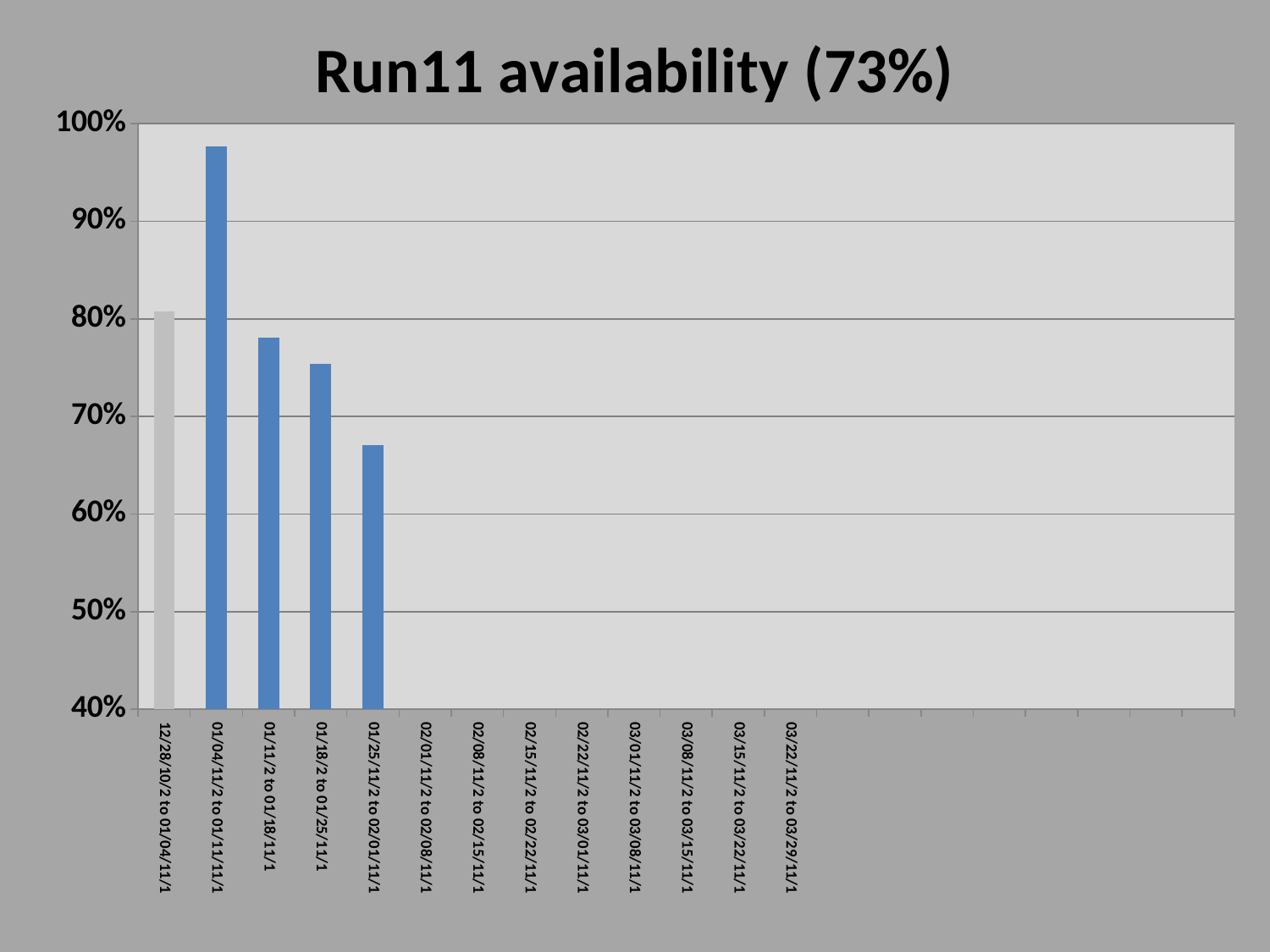
How many category labels are shown along the x axis? 13 Which is larger, the value for 01/11/2 to 01/18/11/1 or the value for 01/18/2 to 01/25/11/1? 01/11/2 to 01/18/11/1 Which period has the highest availability? 01/04/11/2 to 01/11/11/1 What is the lowest value shown on the y axis? 40% Is the value for 01/25/11/2 to 02/01/11/1 greater or less than 70%? less From 01/04/11/2 to 01/11/11/1 through 01/25/11/2 to 02/01/11/1, do the bar values rise or fall? fall Is the value for 12/28/10/2 to 01/04/11/1 greater or less than 70%? greater Among the periods with a plotted bar, which has the lowest availability? 01/25/11/2 to 02/01/11/1 Is the value for 01/04/11/2 to 01/11/11/1 greater or less than 90%? greater How many bars are plotted in the chart? 5 What is the title of the chart? Run11 availability (73%) What kind of chart is shown on the slide? bar chart